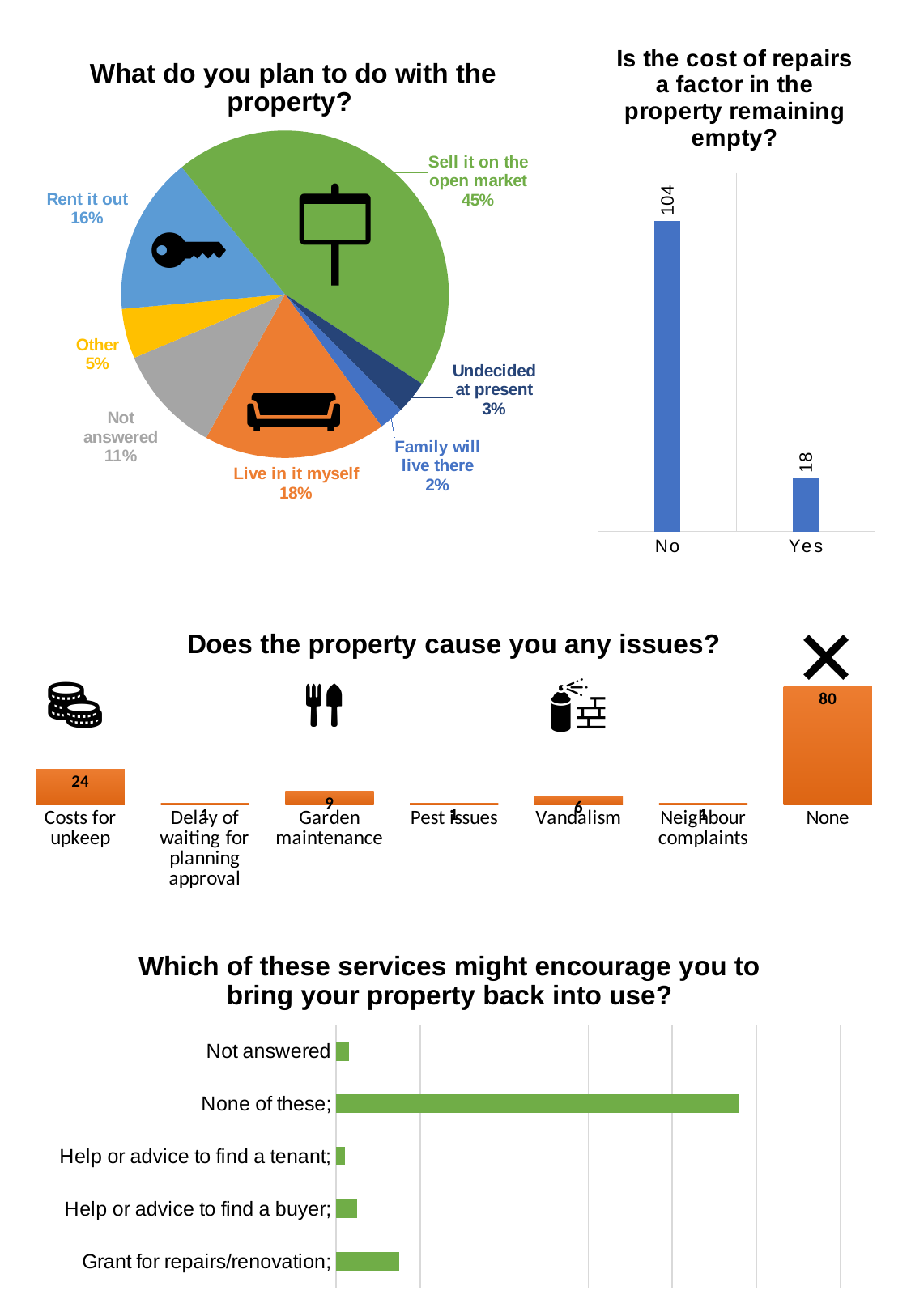
In the chart 'Does the property cause you any issues?', what is the value for 'Costs for upkeep'? 24 In the pie chart 'What do you plan to do with the property?', which option has the smallest share? Family will live there In the chart 'Does the property cause you any issues?', which is larger: 'Garden maintenance' or 'Vandalism'? Garden maintenance In the pie chart 'What do you plan to do with the property?', what share is 'Live in it myself'? 18% What type of chart is 'Is the cost of repairs a factor in the property remaining empty?'? Bar chart In the chart 'Which of these services might encourage you to bring your property back into use?', which category has the longest bar? None of these; In the pie chart 'What do you plan to do with the property?', how many slices are there? 7 In the pie chart 'What do you plan to do with the property?', what percentage plan to sell it on the open market? 45% In the chart 'Is the cost of repairs a factor in the property remaining empty?', what is the difference between 'No' and 'Yes'? 86 In the pie chart 'What do you plan to do with the property?', what is the difference in percentage points between 'Rent it out' and 'Not answered'? 5 In the chart 'Does the property cause you any issues?', which category has the highest value? None In the chart 'Is the cost of repairs a factor in the property remaining empty?', what is the value for 'No'? 104